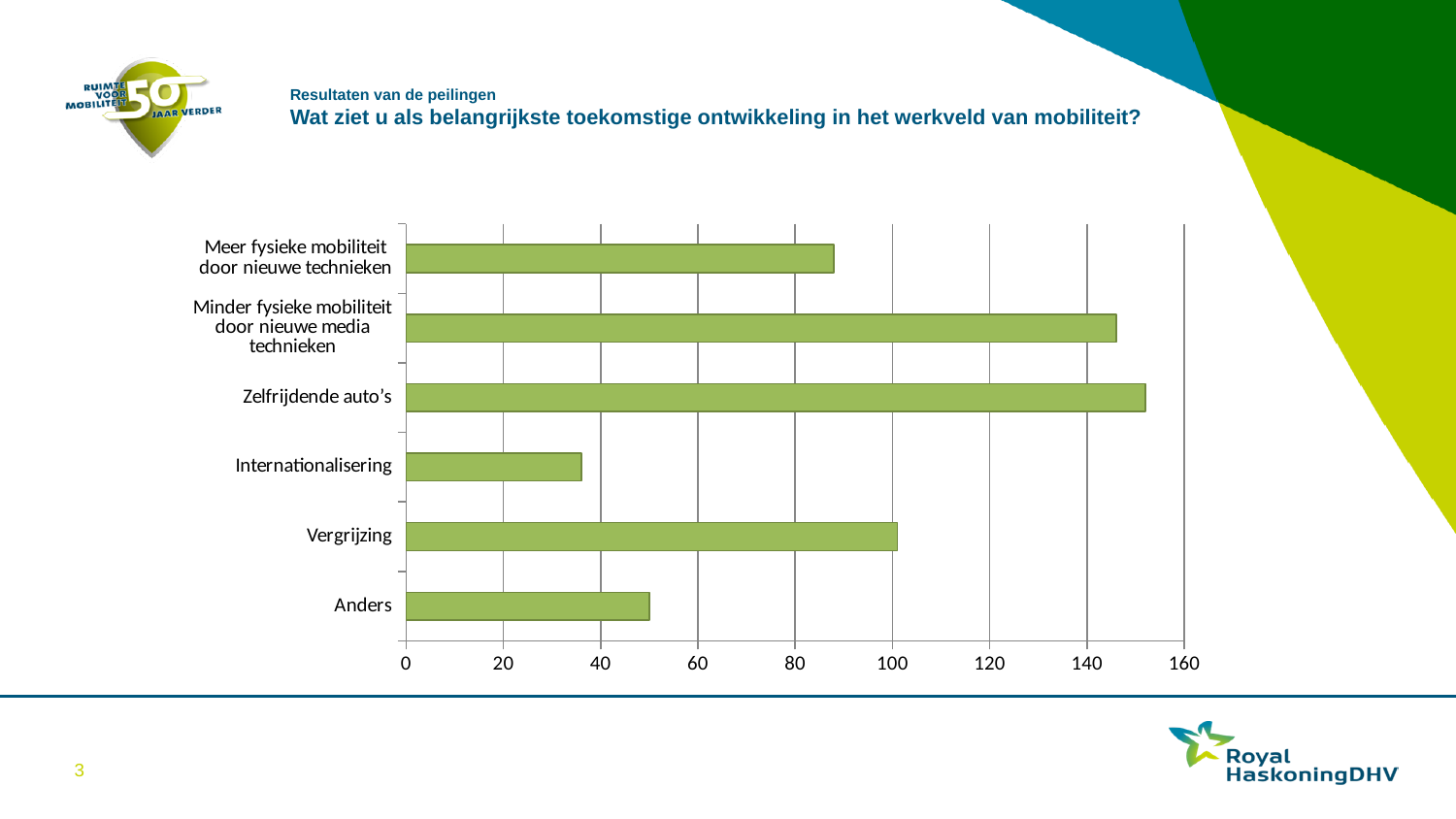
Which category has the lowest value in the chart? Internationalisering Which is larger, the value for Vergrijzing or the value for Meer fysieke mobiliteit door nieuwe technieken? Vergrijzing What kind of chart is shown on the slide? bar chart Is the value for Meer fysieke mobiliteit door nieuwe technieken greater or less than 100? less Is the value for Anders greater or less than 40? greater Is the value for Internationalisering greater or less than 40? less How many categories are shown in the chart? 6 What is the maximum value shown on the horizontal axis of the chart? 160 Which category has the highest value in the chart? Zelfrijdende auto's